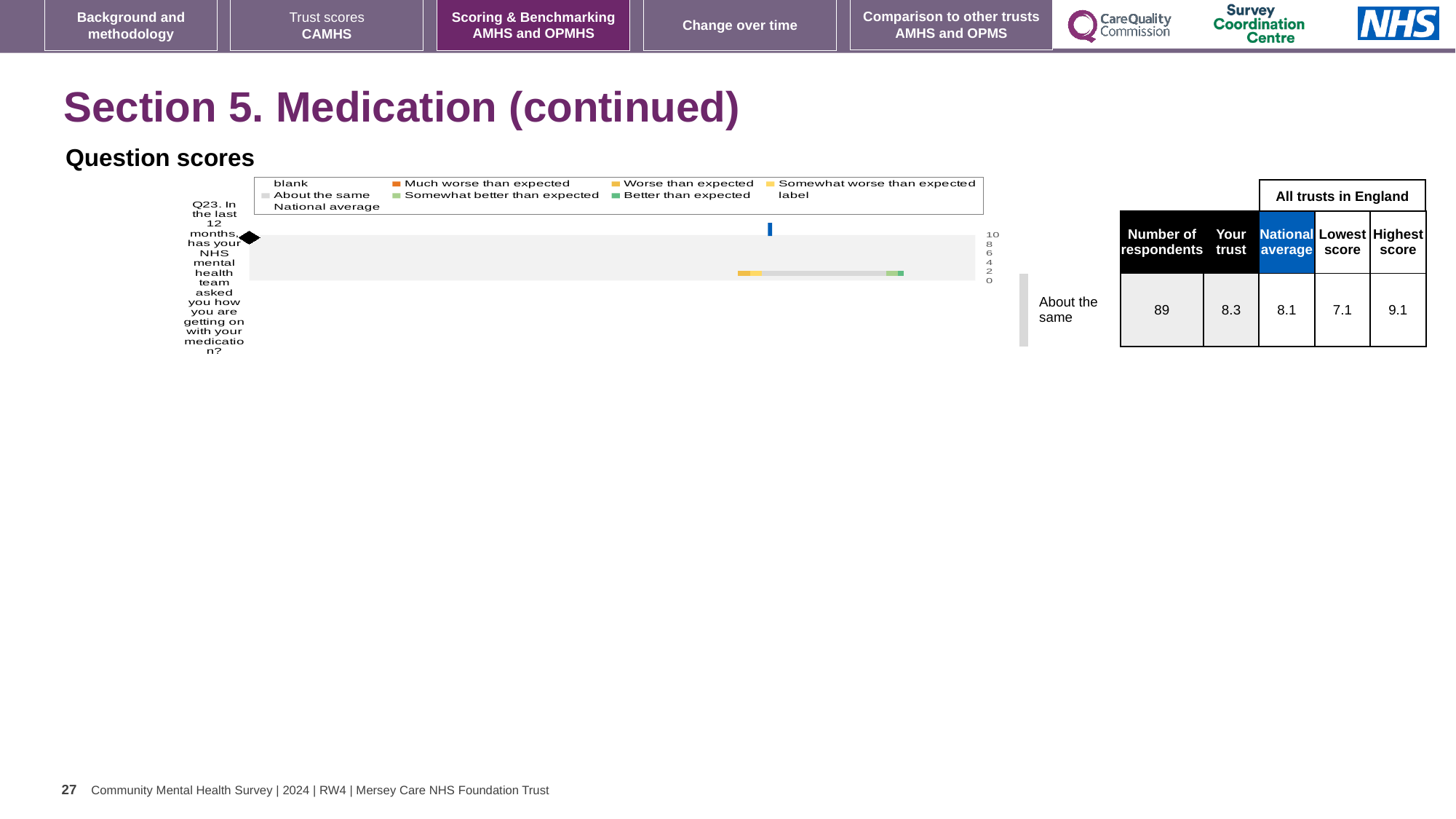
What benchmark category is the trust's Q23 score placed in? About the same What is the national average score for Q23? 8.1 What is the 'Your trust' score for Q23? 8.3 Which is larger for Q23, the 'Your trust' score or the national average? Your trust How many questions (categories) are plotted in the Question scores chart? 1 What is the highest value shown on the chart's axis? 10 Which question number is plotted in the Question scores chart? Q23 How many respondents answered Q23? 89 What is the difference between the highest score and the lowest score for Q23? 2.0 What kind of chart is shown under 'Question scores'? bar chart